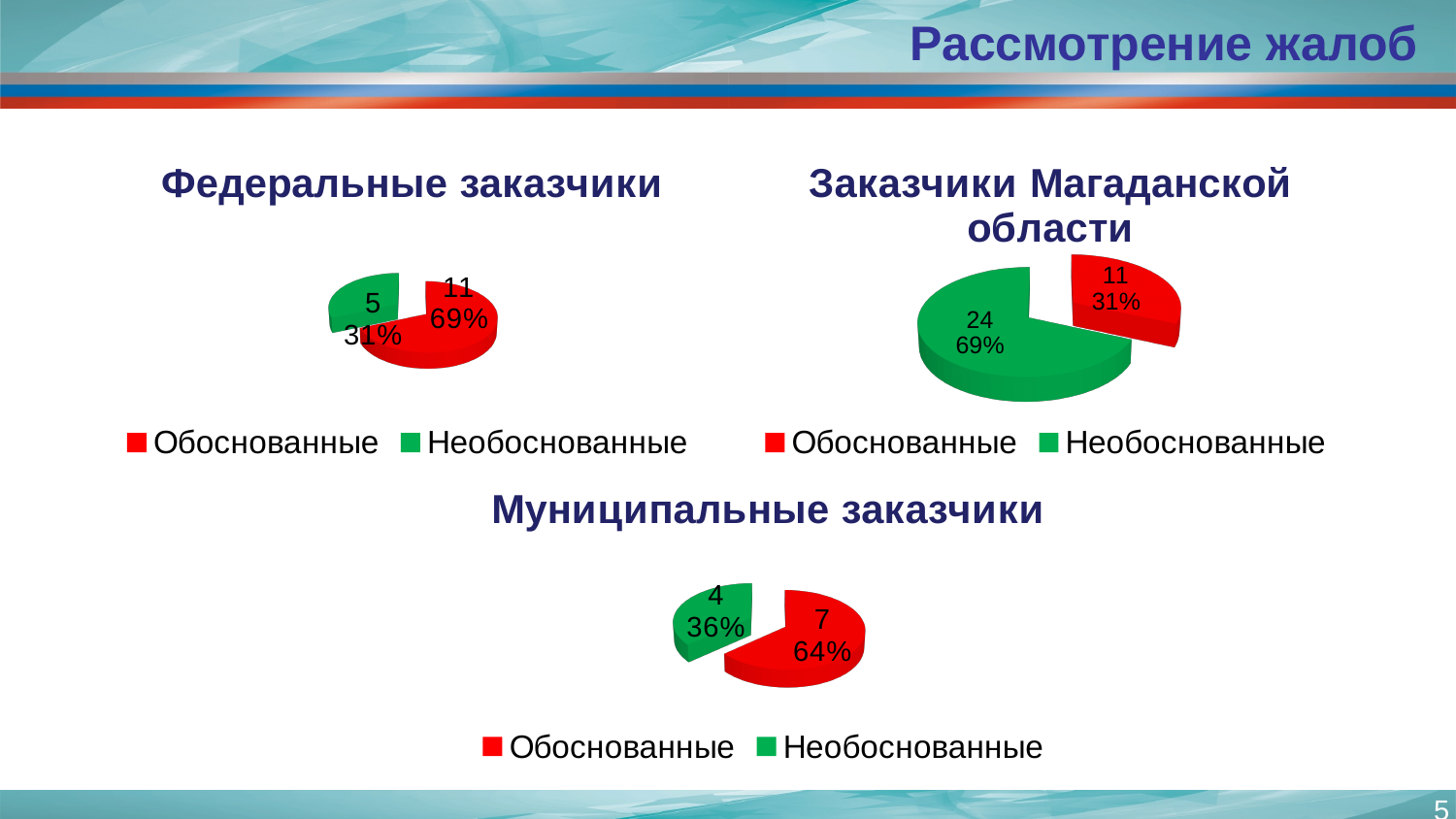
In the 'Федеральные заказчики' chart, which category is the smallest? Необоснованные In the 'Федеральные заказчики' chart, what share of the pie is Необоснованные? 31% In the 'Заказчики Магаданской области' chart, which category is the largest? Необоснованные In the 'Заказчики Магаданской области' chart, what is the total of Обоснованные and Необоснованные? 35 In the 'Муниципальные заказчики' chart, what share of the pie is Необоснованные? 36% What kind of chart is 'Муниципальные заказчики'? Pie chart In the 'Заказчики Магаданской области' chart, what share of the pie is Обоснованные? 31% In the 'Заказчики Магаданской области' chart, what is the value for Необоснованные? 24 In the 'Муниципальные заказчики' chart, what is the difference between Обоснованные and Необоснованные? 3 In the 'Муниципальные заказчики' chart, what is the value for Обоснованные? 7 How many entries does the legend of the 'Федеральные заказчики' chart list? 2 In the 'Федеральные заказчики' chart, what is the value for Обоснованные? 11